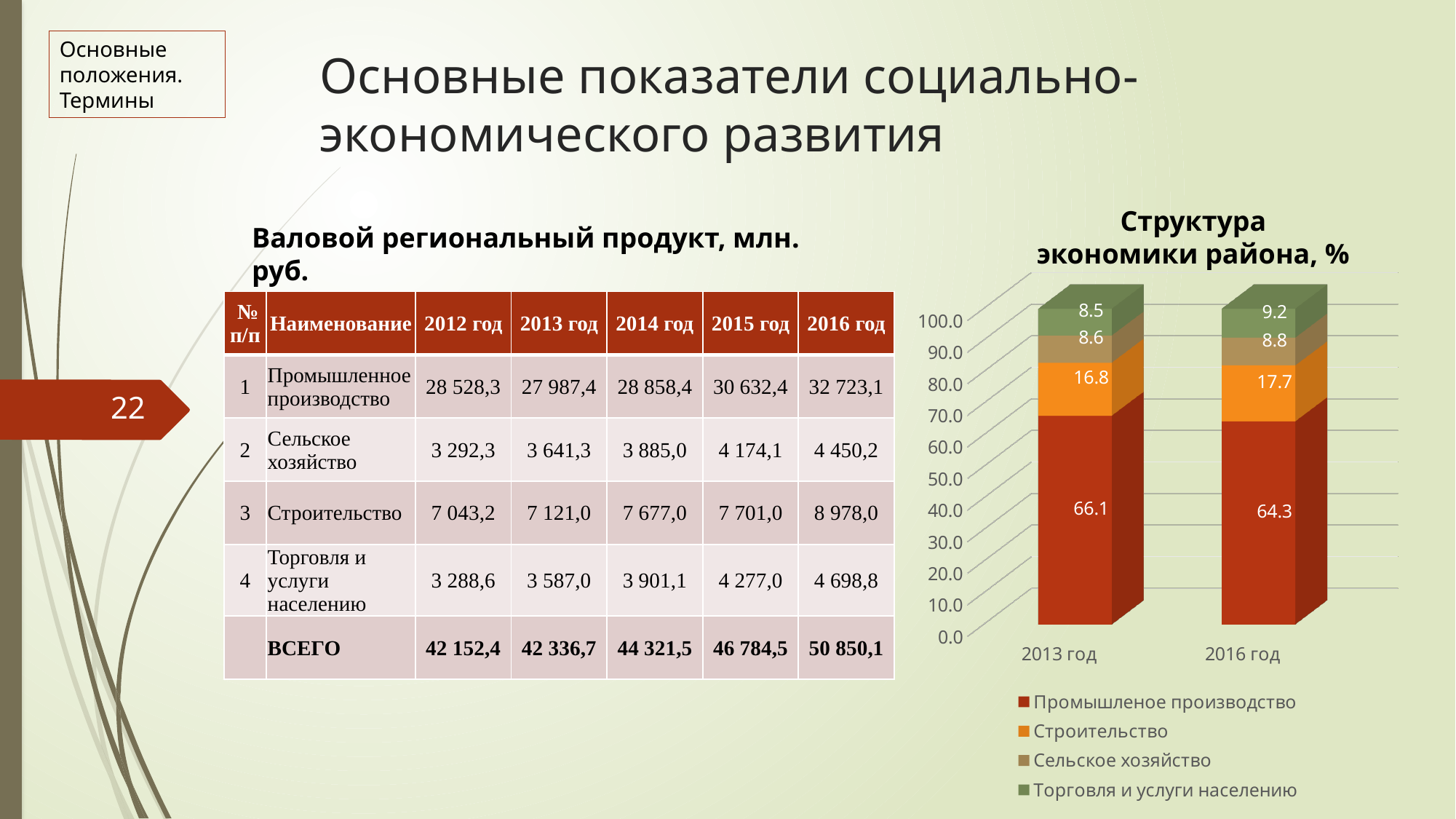
What kind of chart is shown under the title "Структура экономики района, %"? stacked bar chart In the chart "Структура экономики района, %", what is the difference between the Промышленое производство values for 2013 год and 2016 год? 1.8 In the chart "Структура экономики района, %", what is the value for Строительство in 2016 год? 17.7 In the chart "Структура экономики района, %", what is the value for Промышленое производство in 2013 год? 66.1 In the chart "Структура экономики района, %", which series has the largest value in 2016 год? Промышленое производство In the chart "Структура экономики района, %", what is the value for Сельское хозяйство in 2016 год? 8.8 In the chart "Структура экономики района, %", is the Строительство value larger in 2013 год or in 2016 год? 2016 год In the chart "Структура экономики района, %", what is the total of the stacked bar for 2016 год? 100.0 In the chart "Структура экономики района, %", how many categories are shown on the x axis? 2 In the chart "Структура экономики района, %", how many series does the legend list? 4 In the chart "Структура экономики района, %", which series has the smallest value in 2013 год? Торговля и услуги населению In the chart "Структура экономики района, %", what is the value for Торговля и услуги населению in 2013 год? 8.5